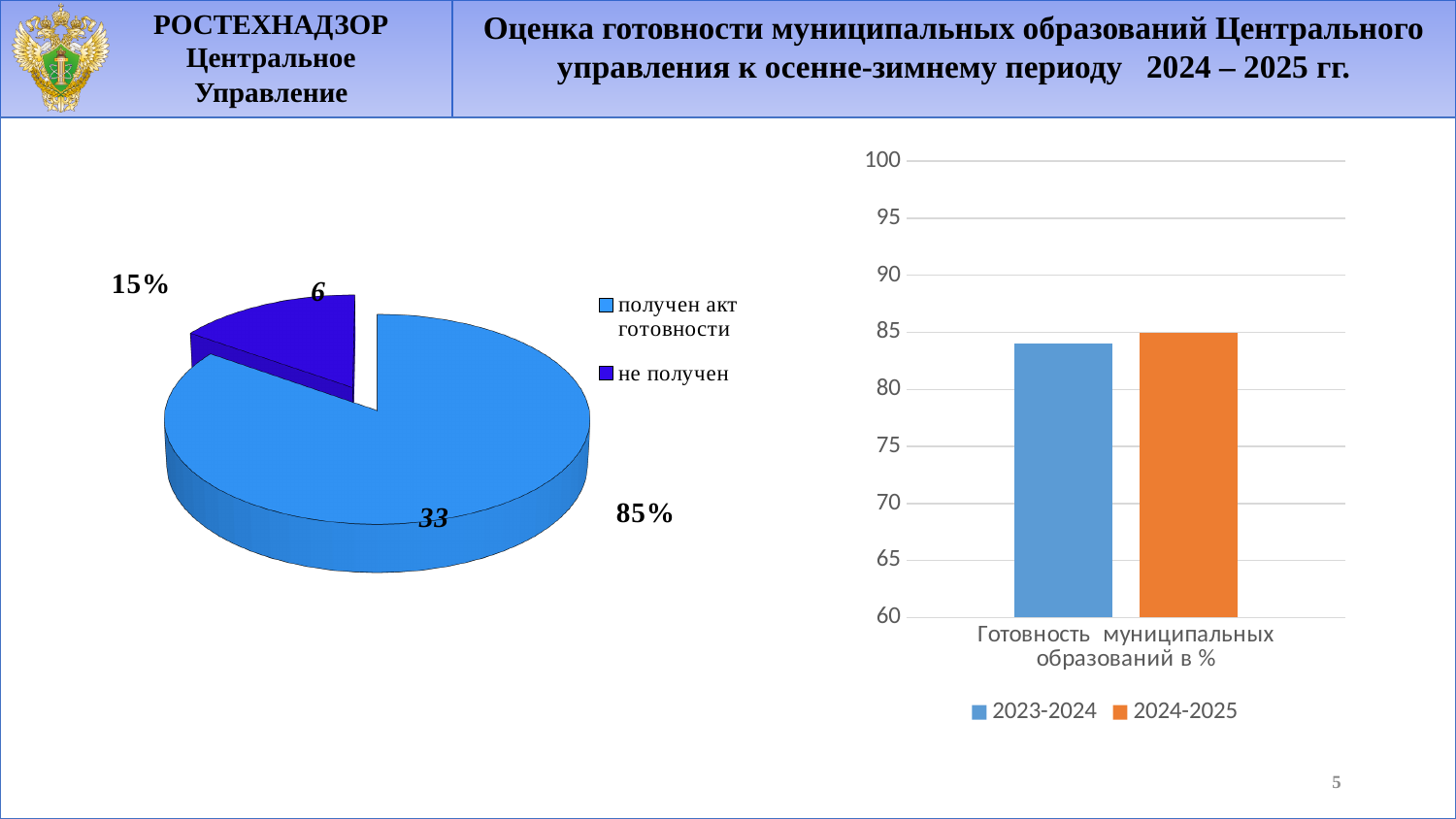
On the pie chart on the left, what percentage share does the 'не получен' slice have? 15% On the pie chart on the left, how many slices are there? 2 On the pie chart on the left, which slice is the largest? получен акт готовности What kind of chart is shown on the right of the slide? Bar chart On the pie chart on the left, what value is shown for the slice 'получен акт готовности'? 33 What kind of chart is shown on the left of the slide? Pie chart On the pie chart on the left, what percentage share does the 'получен акт готовности' slice have? 85% On the bar chart on the right, is the value for 2023-2024 greater or less than 80? greater On the pie chart on the left, what is the total of the two slice values? 39 On the bar chart on the right, which series has the higher value: 2023-2024 or 2024-2025? 2024-2025 On the bar chart on the right, how many series does the legend list? 2 On the pie chart on the left, what value is shown for the slice 'не получен'? 6